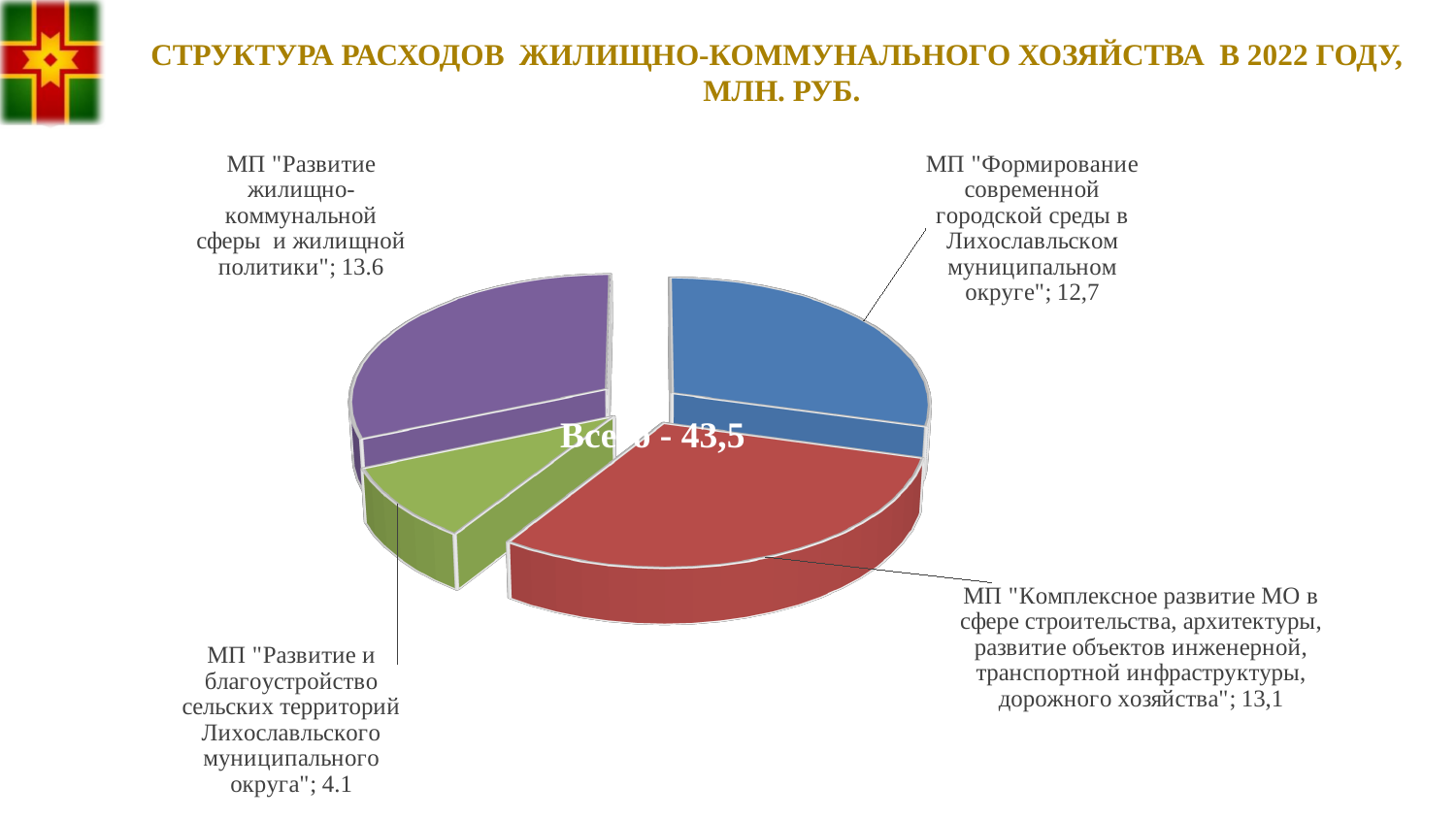
What is the value for МП "Развитие и благоустройство сельских территорий Лихославльского муниципального округа"? 4.1 What is the value for МП "Развитие жилищно-коммунальной сферы и жилищной политики"? 13.6 How many slices does the pie chart have? 4 Which program has the largest share of expenditures in the pie chart? МП "Развитие жилищно-коммунальной сферы и жилищной политики" Which program has the smallest share of expenditures in the pie chart? МП "Развитие и благоустройство сельских территорий Лихославльского муниципального округа" What is the value for МП "Комплексное развитие МО в сфере строительства, архитектуры, развитие объектов инженерной, транспортной инфраструктуры, дорожного хозяйства"? 13,1 Which is larger: the value for МП "Комплексное развитие МО..." or the value for МП "Формирование современной городской среды..."? МП "Комплексное развитие МО..." (13,1) What is the title of the chart on the slide? СТРУКТУРА РАСХОДОВ ЖИЛИЩНО-КОММУНАЛЬНОГО ХОЗЯЙСТВА В 2022 ГОДУ, МЛН. РУБ. What is the value for МП "Формирование современной городской среды в Лихославльском муниципальном округе"? 12,7 What type of chart is shown on the slide? Pie chart What is the total of all expenditures shown in the centre of the pie chart? 43,5 What is the difference between the value for МП "Развитие жилищно-коммунальной сферы и жилищной политики" (13.6) and МП "Развитие и благоустройство сельских территорий Лихославльского муниципального округа" (4.1)? 9.5